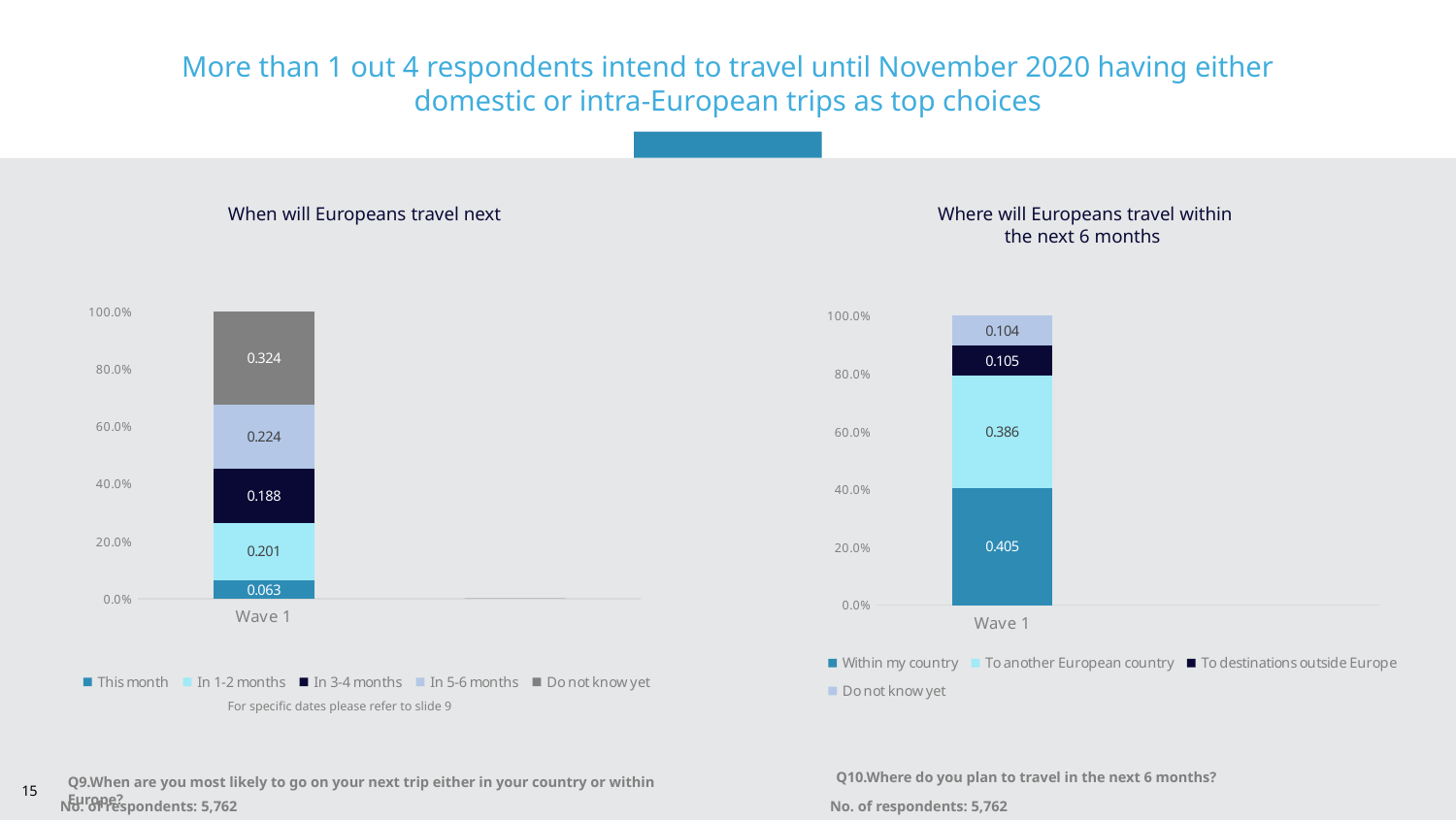
In the 'When will Europeans travel next' chart, what is the difference between 'In 5-6 months' and 'In 3-4 months'? 0.036 What kind of chart is 'Where will Europeans travel within the next 6 months'? Stacked bar chart In the 'When will Europeans travel next' chart, which series has the smallest value? This month In the 'Where will Europeans travel within the next 6 months' chart, what is the difference between 'Within my country' and 'To another European country'? 0.019 In the 'When will Europeans travel next' chart, which series has the largest value? Do not know yet In the 'Where will Europeans travel within the next 6 months' chart, what is the total of the Wave 1 stacked bar? 1.000 In the 'When will Europeans travel next' chart, what is the value for 'This month'? 0.063 In the 'Where will Europeans travel within the next 6 months' chart, what is the value for 'Within my country'? 0.405 In the 'Where will Europeans travel within the next 6 months' chart, which is larger: 'Within my country' or 'To destinations outside Europe'? Within my country In the 'When will Europeans travel next' chart, how many series does the legend list? 5 In the 'Where will Europeans travel within the next 6 months' chart, what is the value for 'To another European country'? 0.386 In the 'When will Europeans travel next' chart, what is the value for 'Do not know yet'? 0.324